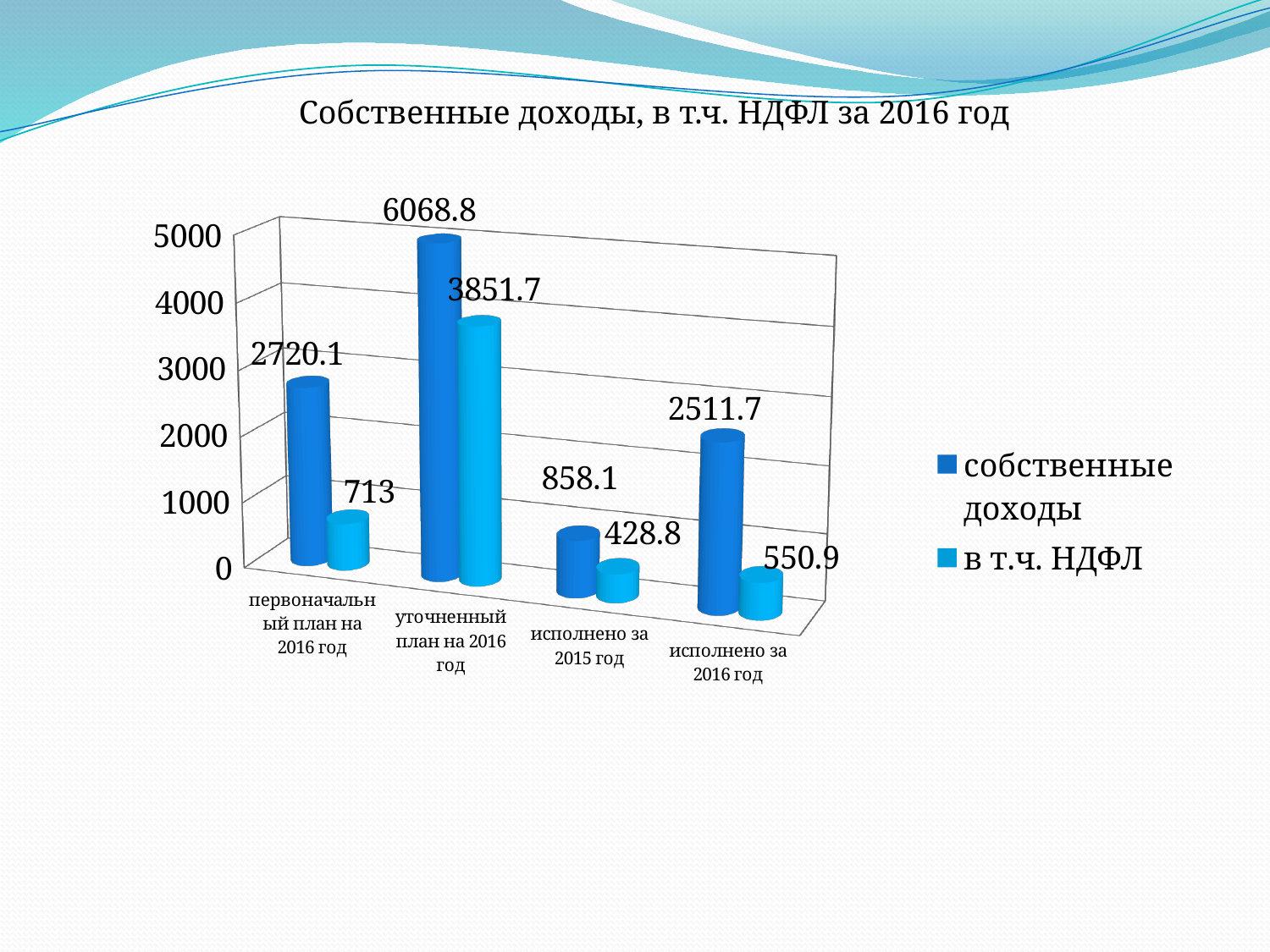
Which category has the highest value for собственные доходы? уточненный план на 2016 год What is the value of собственные доходы for исполнено за 2016 год? 2511.7 What kind of chart is shown on the slide? bar chart What is the difference between собственные доходы for уточненный план на 2016 год and for исполнено за 2016 год? 3557.1 Which category has the lowest value for в т.ч. НДФЛ? исполнено за 2015 год What is the value of в т.ч. НДФЛ for исполнено за 2015 год? 428.8 What is the value of в т.ч. НДФЛ for первоначальный план на 2016 год? 713 What is the value of собственные доходы for уточненный план на 2016 год? 6068.8 How many categories are shown on the x axis? 4 What is the title of the chart? Собственные доходы, в т.ч. НДФЛ за 2016 год How many series does the legend list? 2 Which is larger: собственные доходы for первоначальный план на 2016 год or for исполнено за 2016 год? первоначальный план на 2016 год